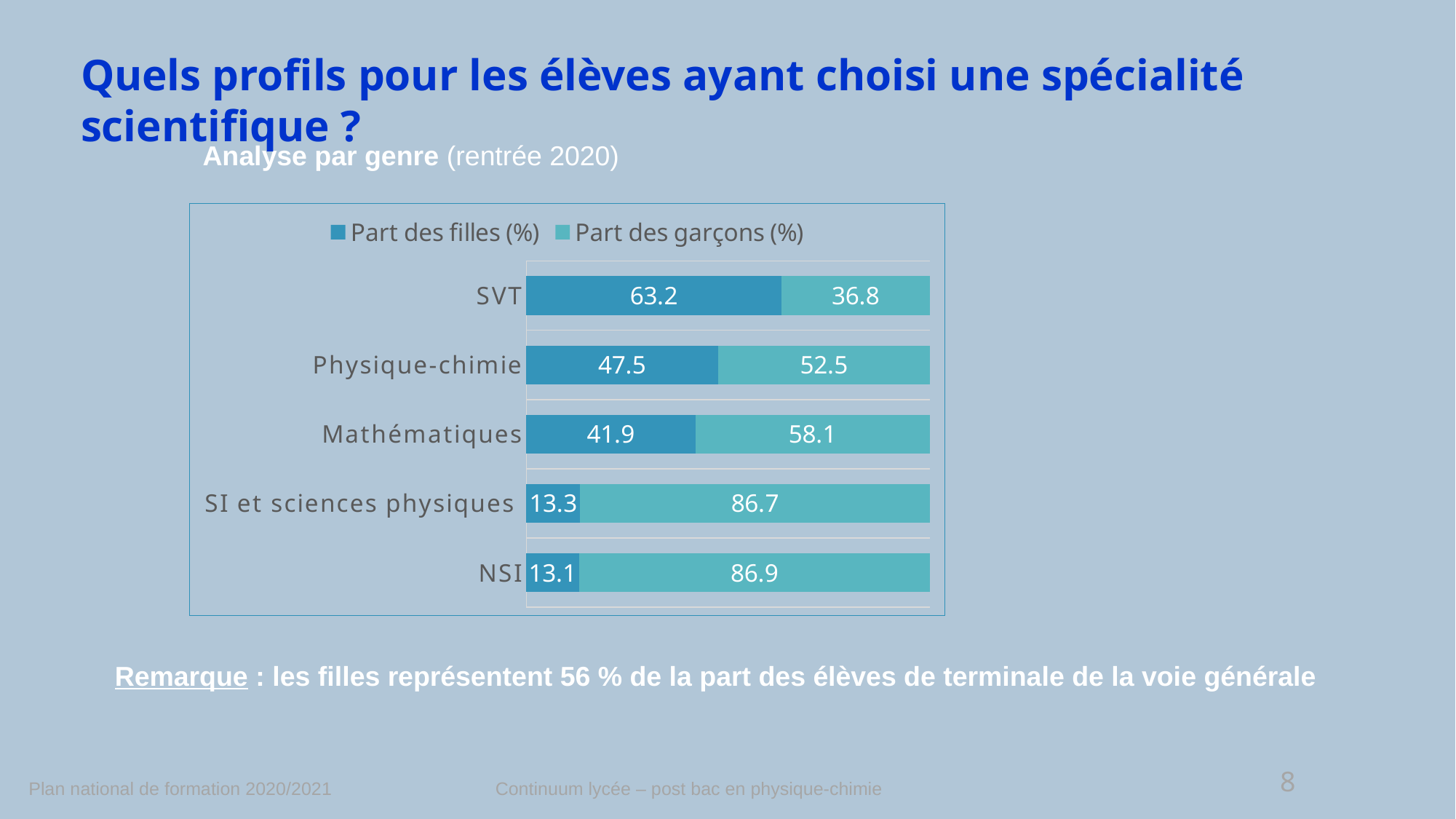
Which category has the lowest value for Part des garçons (%)? SVT What is the value of Part des garçons (%) for Mathématiques? 58.1 Which is larger for Physique-chimie: Part des filles (%) or Part des garçons (%)? Part des garçons (%) What is the difference between Part des garçons (%) and Part des filles (%) for SI et sciences physiques? 73.4 Which category has the highest value for Part des filles (%)? SVT How many categories are shown in the chart? 5 What is the value of Part des garçons (%) for Physique-chimie? 52.5 How many series does the legend list? 2 What is the total of the stacked bar for Mathématiques? 100 What is the value of Part des filles (%) for SVT? 63.2 What is the value of Part des filles (%) for NSI? 13.1 What kind of chart is shown on the slide? Stacked bar chart